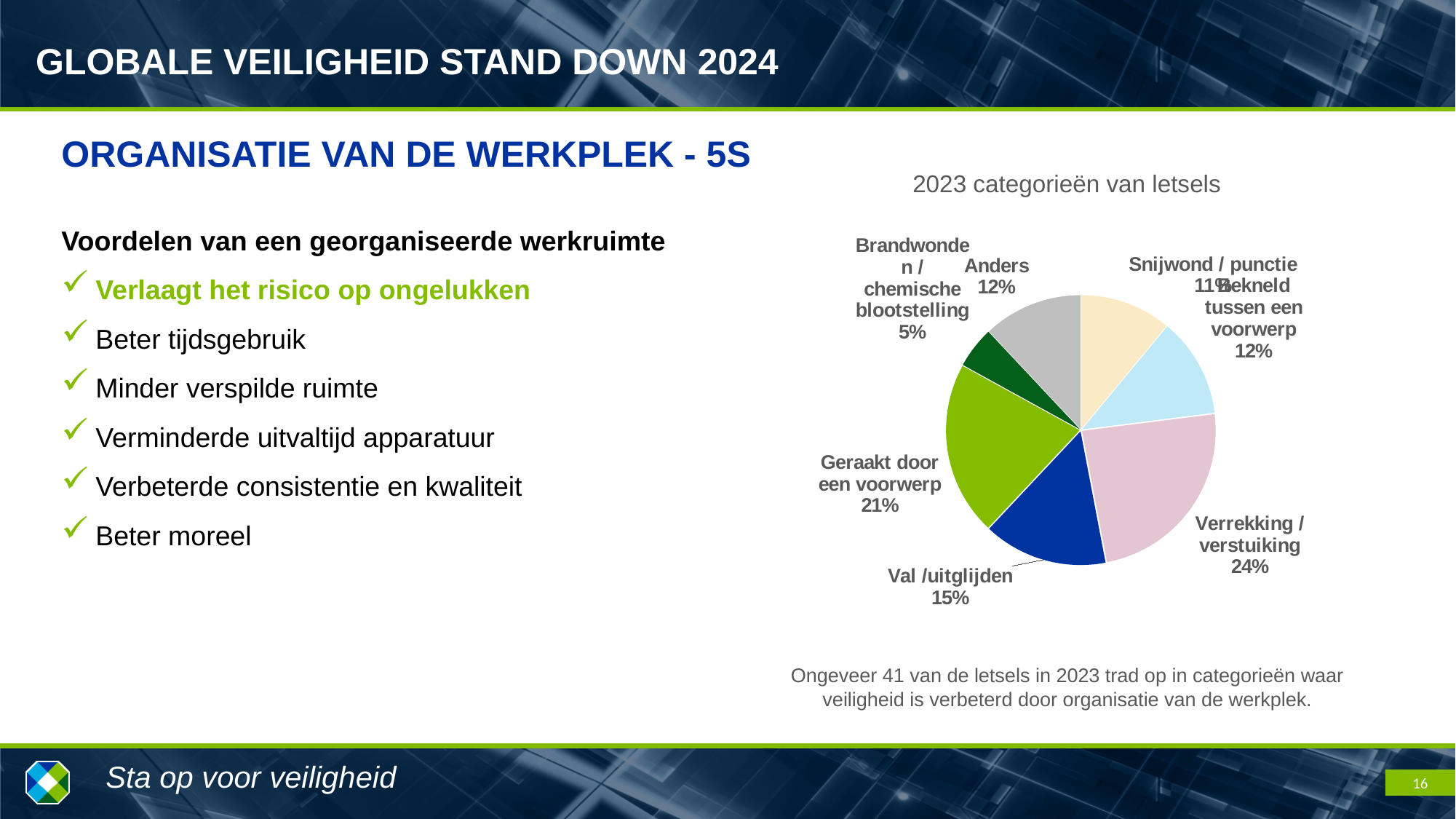
What percentage is shown for 'Bekneld tussen een voorwerp'? 12% How many categories (slices) does the pie chart have? 7 What percentage is shown for 'Anders'? 12% What is the difference in percentage points between 'Verrekking / verstuiking' and 'Geraakt door een voorwerp'? 3 What is the title of the chart? 2023 categorieën van letsels What kind of chart is shown on the slide? pie chart What share of the pie is 'Geraakt door een voorwerp'? 21% What percentage is shown for 'Verrekking / verstuiking'? 24% Which category has the smallest share of the pie? Brandwonden / chemische blootstelling Which category has the largest share of the pie? Verrekking / verstuiking Which is larger: 'Val /uitglijden' or 'Geraakt door een voorwerp'? Geraakt door een voorwerp What percentage is shown for 'Val /uitglijden'? 15%